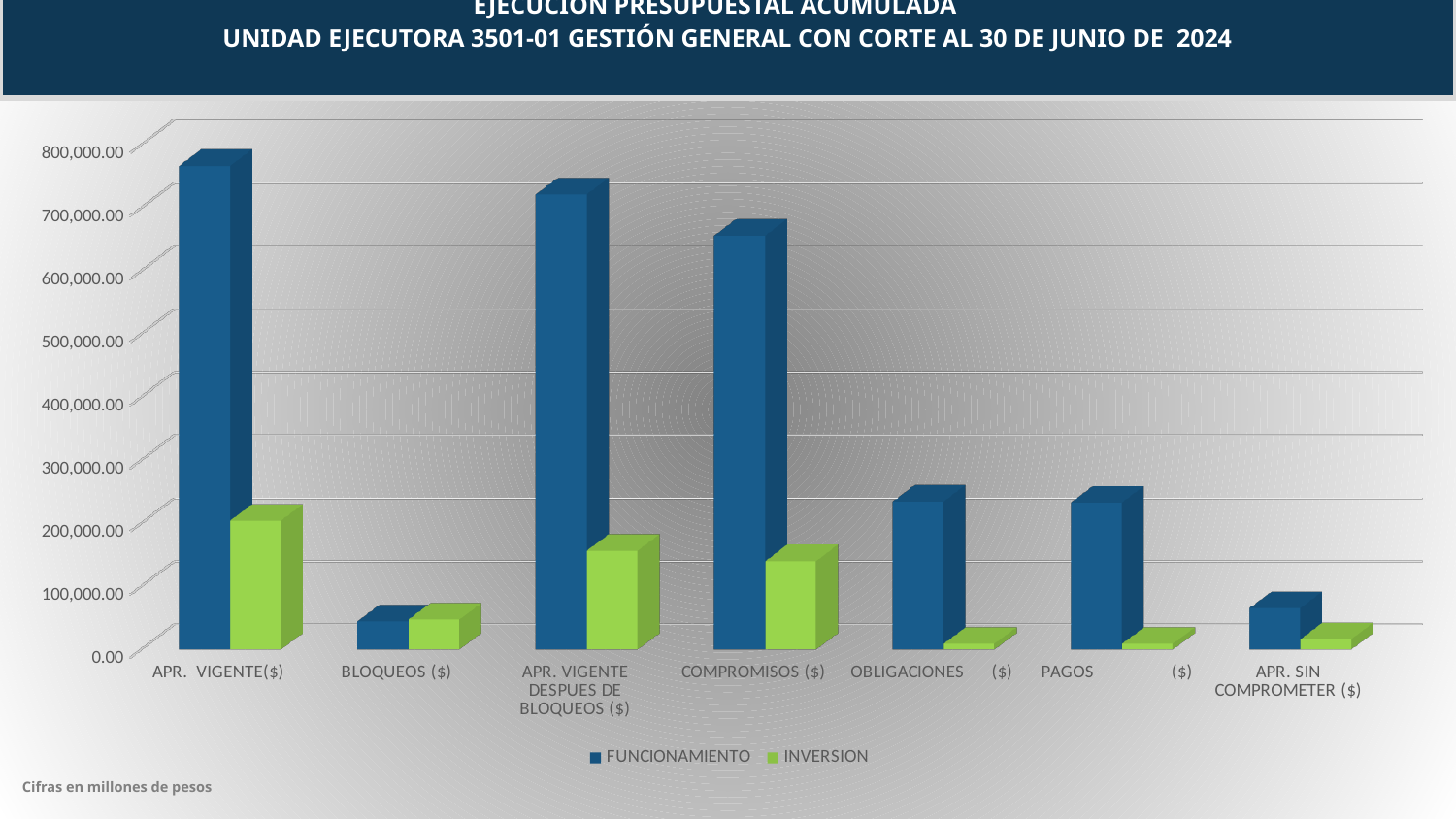
What kind of chart is shown on the slide? Bar chart Which is larger: the FUNCIONAMIENTO value for OBLIGACIONES ($) or the FUNCIONAMIENTO value for APR. SIN COMPROMETER ($)? OBLIGACIONES ($) Is the INVERSION value for APR. VIGENTE($) greater or less than 300,000.00? less Which category has the highest FUNCIONAMIENTO value? APR. VIGENTE($) Is the FUNCIONAMIENTO value for APR. VIGENTE($) greater or less than 700,000.00? greater Which category has the highest INVERSION value? APR. VIGENTE($) Which series is shown in green? INVERSION How many categories are shown along the x axis? 7 How many series does the legend list? 2 According to the note at the bottom left, in what units are the figures expressed? Millones de pesos Which category has the lowest FUNCIONAMIENTO value? BLOQUEOS ($) Is the FUNCIONAMIENTO value for COMPROMISOS ($) greater or less than 600,000.00? greater